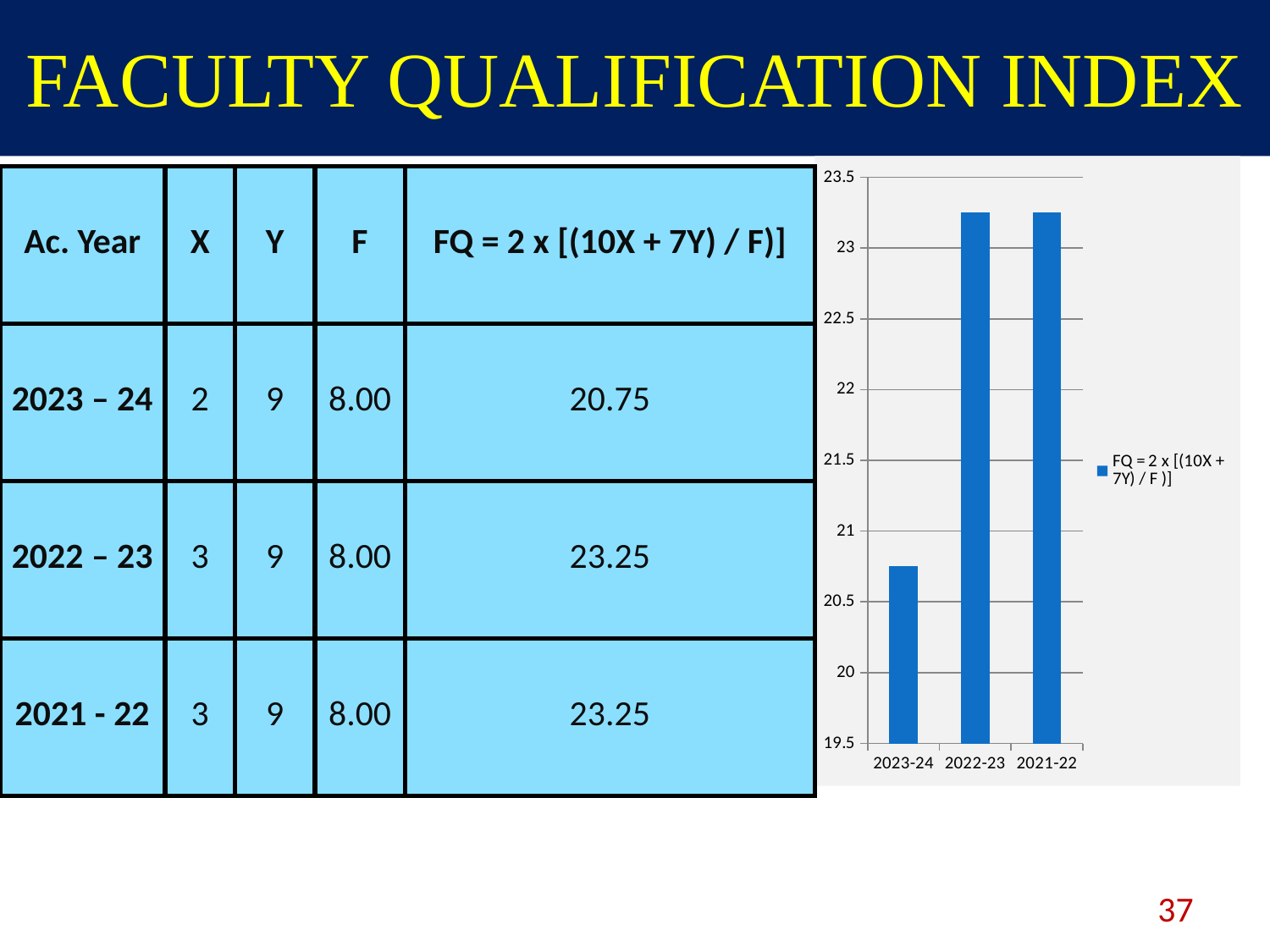
How many series does the chart legend list? 1 How many academic years are plotted on the chart? 3 Which academic year has the lowest bar on the chart? 2023-24 Is the bar for 2022-23 greater or less than 23? greater What is the FQ value for 2021-22 shown on the slide? 23.25 What type of chart is shown on the slide? bar chart Which is larger on the chart, the value for 2023-24 or the value for 2022-23? 2022-23 What is the difference between the FQ values for 2022-23 and 2023-24? 2.50 Is the bar for 2023-24 greater or less than 21? less What is the FQ value for 2023-24 shown on the slide? 20.75 What is the legend entry for the series plotted on the chart? FQ = 2 x [(10X + 7Y) / F )] Is the bar for 2021-22 greater or less than 22.5? greater